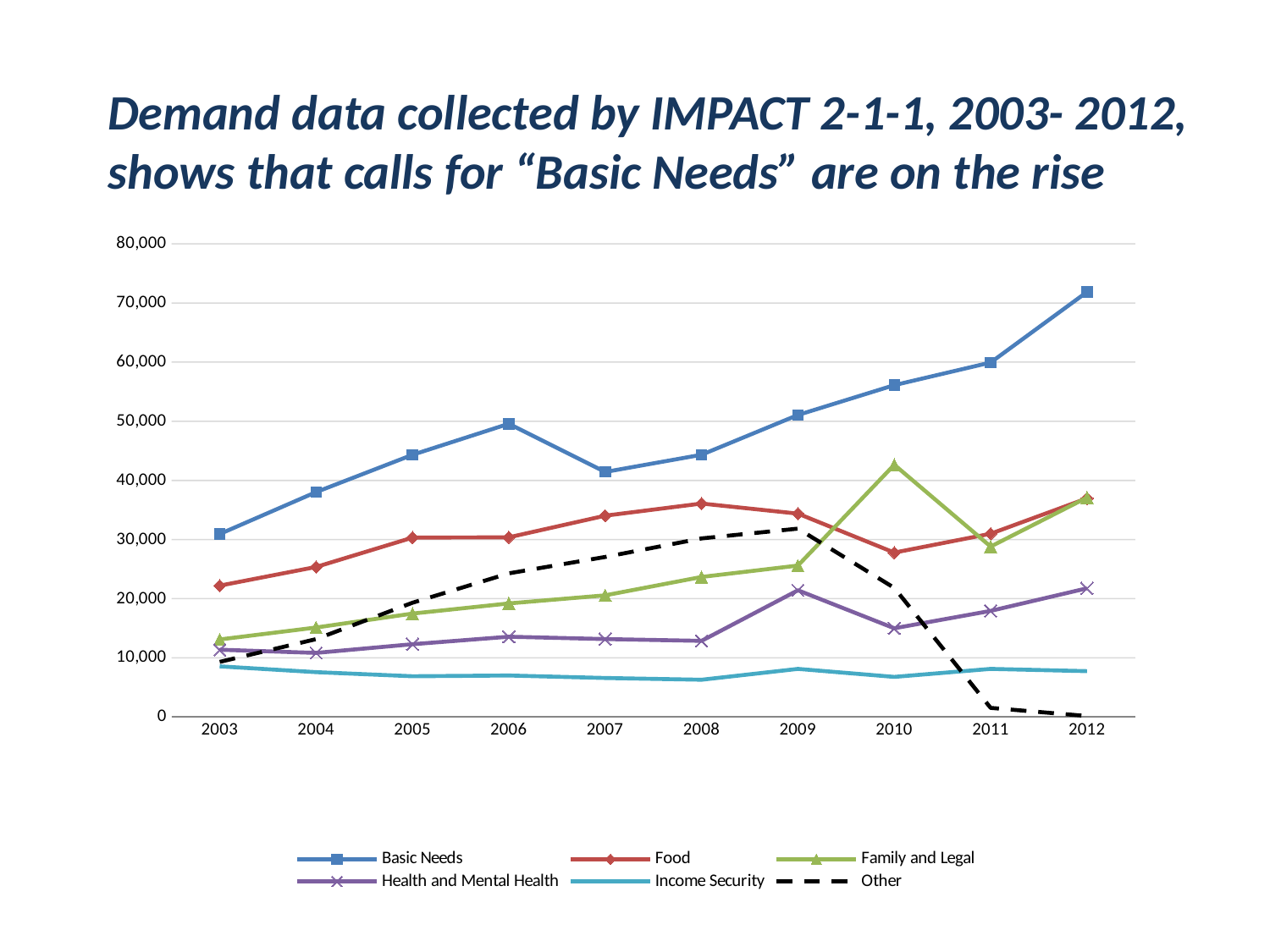
Does the Basic Needs line rise or fall overall from 2003 to 2012? rise Is the value for Other in 2011 greater or less than 10,000? less In which year is the value for Basic Needs lowest? 2003 Is the value for Basic Needs in 2012 greater or less than 70,000? greater Which series has the lowest value in 2012? Other Is the value for Basic Needs in 2010 greater or less than 50,000? greater Which series is drawn as a dashed black line? Other In 2010, which is larger: Family and Legal or Food? Family and Legal In which year is the value for Basic Needs highest? 2012 How many years are plotted along the x axis? 10 What kind of chart is shown on the slide? line chart How many series does the legend list? 6